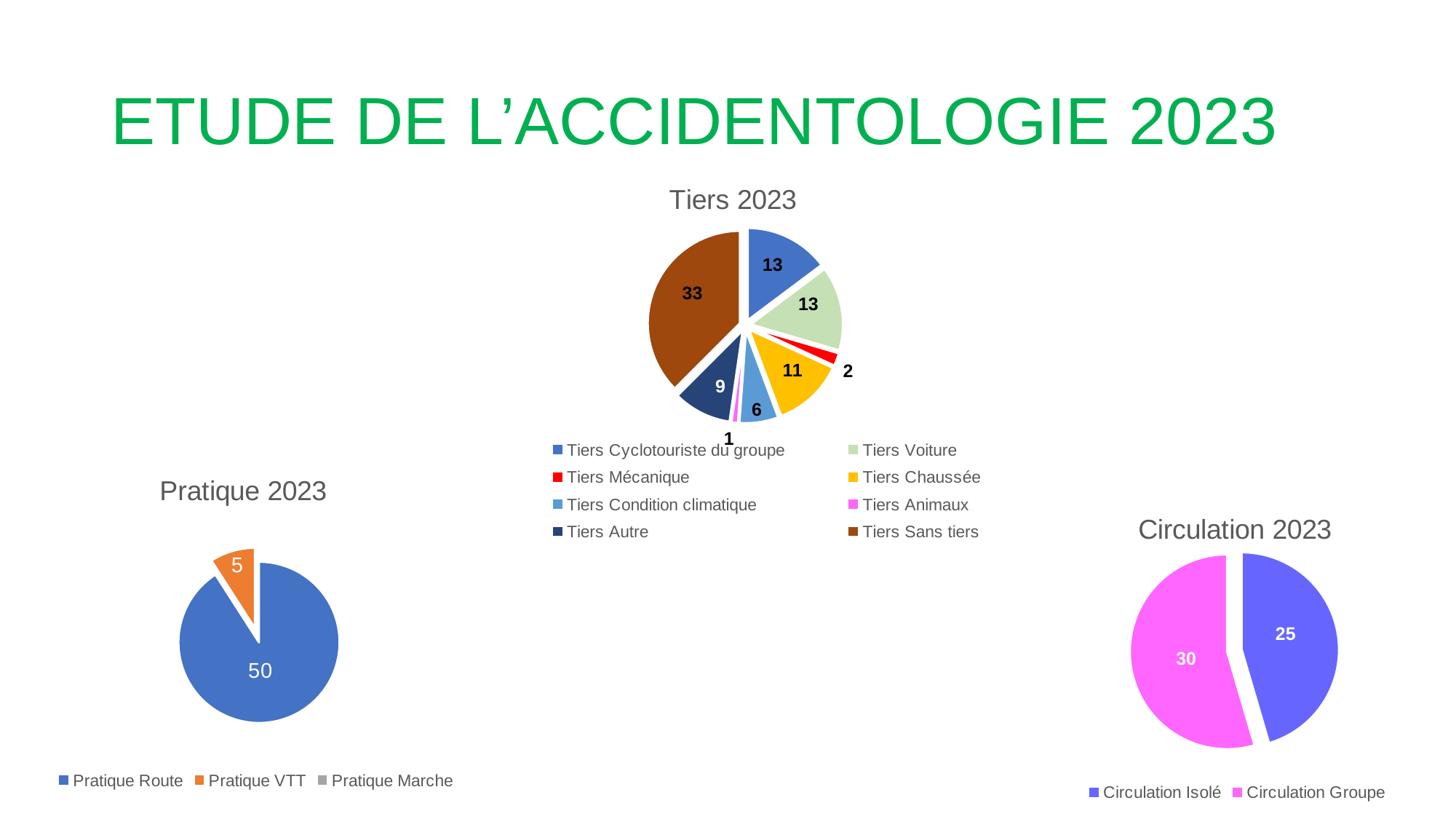
In the Tiers 2023 chart, how many categories does the legend list? 8 In the Tiers 2023 chart, which category has the smallest slice? Tiers Animaux In the Tiers 2023 chart, which category has the largest slice? Tiers Sans tiers In the Circulation 2023 chart, what is the difference between Circulation Groupe and Circulation Isolé? 5 In the Tiers 2023 chart, what is the difference between Tiers Sans tiers and Tiers Autre? 24 In the Circulation 2023 chart, what is the value for Circulation Isolé? 25 In the Tiers 2023 chart, what is the total of all slices? 88 In the Pratique 2023 chart, which is larger, Pratique Route or Pratique VTT? Pratique Route In the Tiers 2023 chart, what is the value for Tiers Chaussée? 11 In the Pratique 2023 chart, what is the value for Pratique VTT? 5 In the Tiers 2023 chart, what is the value for Tiers Sans tiers? 33 What kind of chart is the Circulation 2023 chart? Pie chart